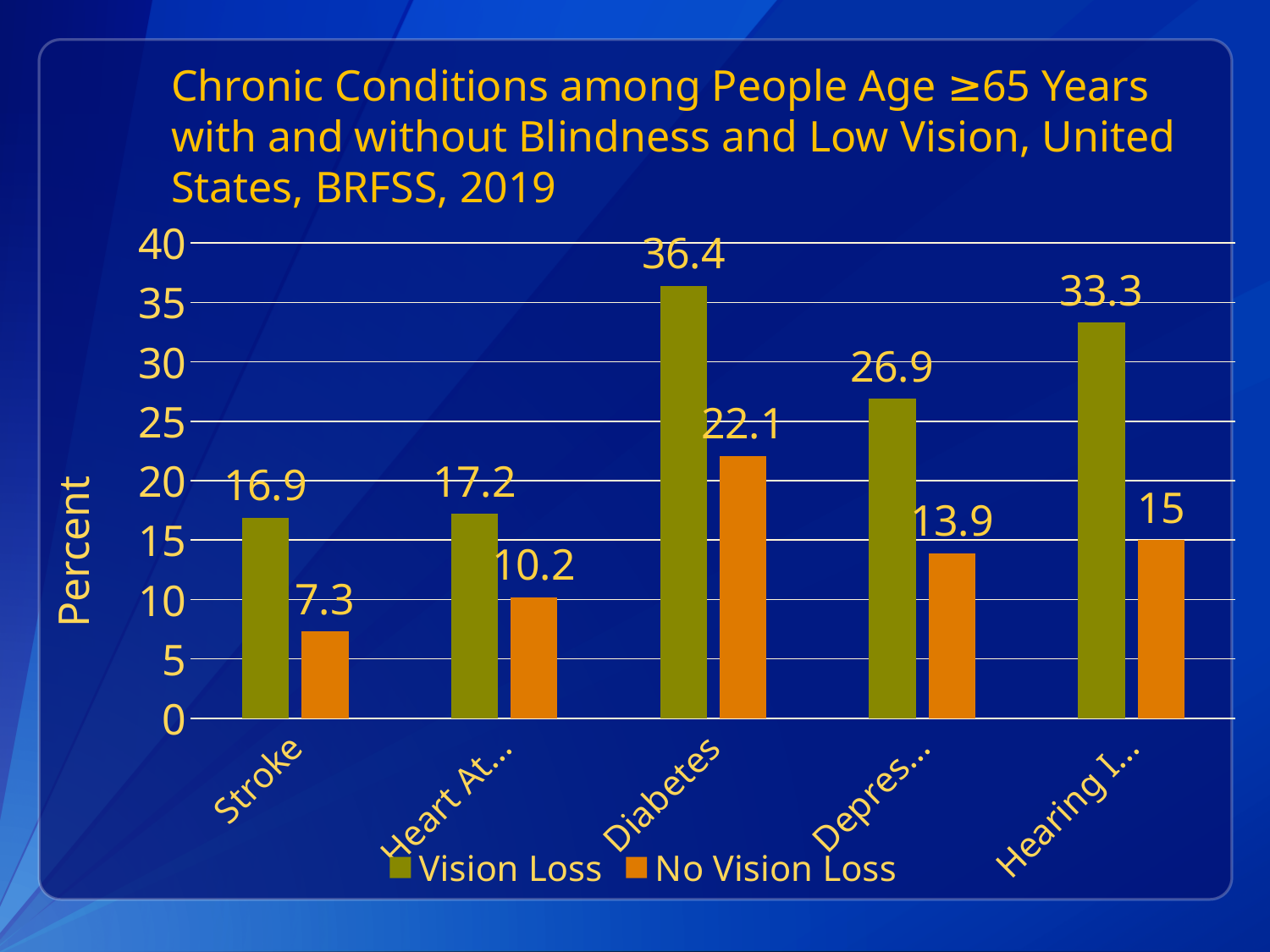
What is the No Vision Loss value for Diabetes? 22.1 How many series does the legend list? 2 How many categories are shown on the x axis? 5 What is the Vision Loss value for Diabetes? 36.4 Which is larger for Diabetes: the Vision Loss value or the No Vision Loss value? Vision Loss What is the Vision Loss value for Stroke? 16.9 What is the difference between the Vision Loss and No Vision Loss values for Stroke? 9.6 What is the No Vision Loss value for Stroke? 7.3 Which category has the lowest No Vision Loss value? Stroke Which category has the highest Vision Loss value? Diabetes What is the difference between the Vision Loss and No Vision Loss values for Diabetes? 14.3 What kind of chart is shown on the slide? Bar chart